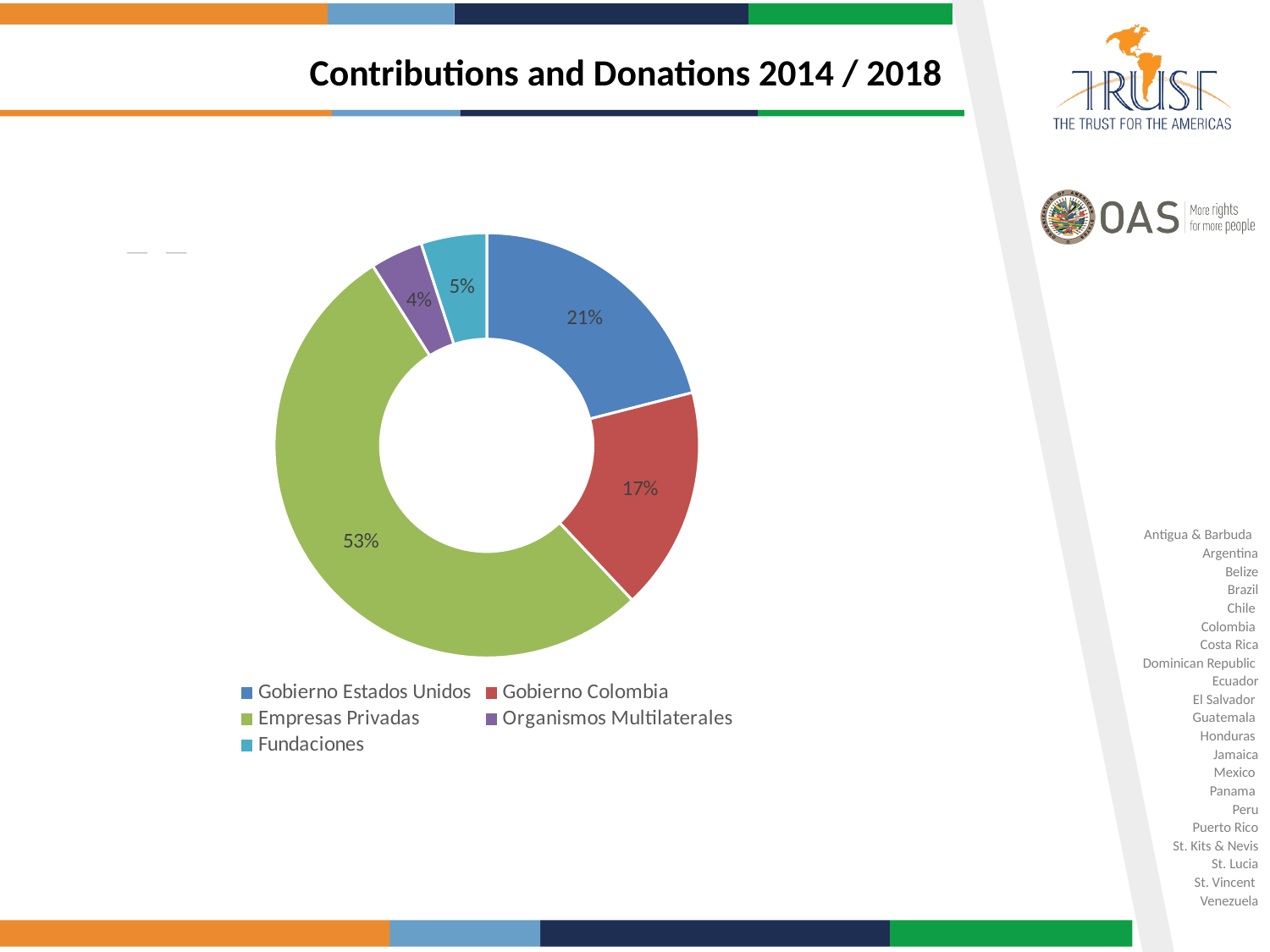
What percentage is shown for Gobierno Colombia? 17% What percentage is shown for Gobierno Estados Unidos? 21% Which category has the smallest share of the chart? Organismos Multilaterales Which category has the largest share of the chart? Empresas Privadas What is the title of the slide containing the chart? Contributions and Donations 2014 / 2018 How many categories are shown in the chart? 5 Which is larger, the share for Fundaciones or the share for Organismos Multilaterales? Fundaciones What share of contributions and donations comes from Empresas Privadas? 53% What percentage is shown for Organismos Multilaterales? 4% What is the difference in percentage points between Gobierno Estados Unidos and Gobierno Colombia? 4 What percentage is shown for Fundaciones? 5% What kind of chart is shown on the slide? Doughnut chart